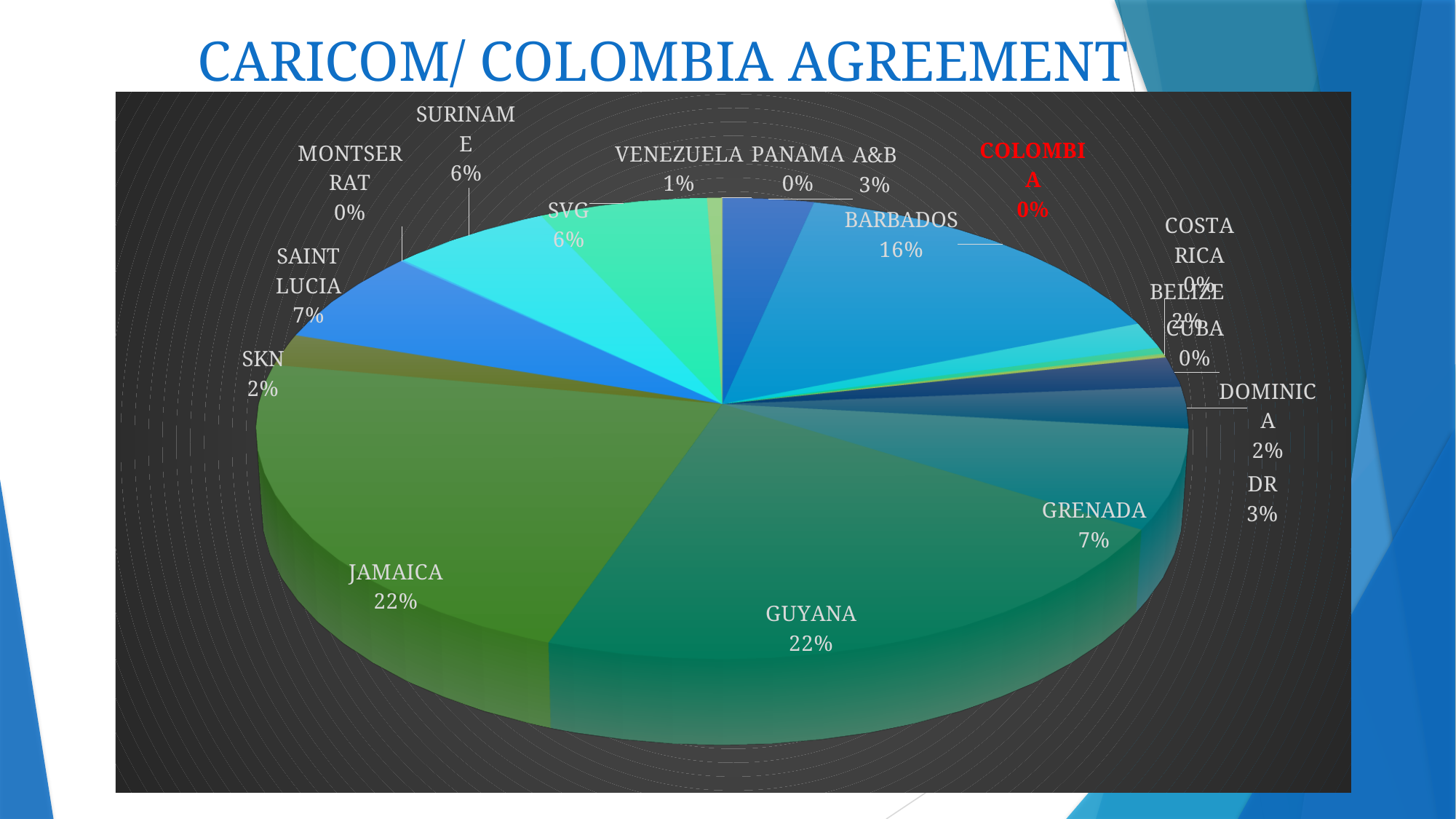
Which is larger, the share for Barbados or the share for Grenada? Barbados What share of the pie does Grenada have? 7% What share of the pie does DR have? 3% What is the difference between the shares of Barbados and Saint Lucia? 9% What is the title of the chart? CARICOM/ COLOMBIA AGREEMENT Which category's label is shown in red text? COLOMBIA What share of the pie does SVG have? 6% How many slices (categories) are labelled on the pie chart? 18 What share of the pie does Guyana have? 22% What share of the pie does Colombia have? 0% What share of the pie does Barbados have? 16% What kind of chart is shown on the slide? pie chart